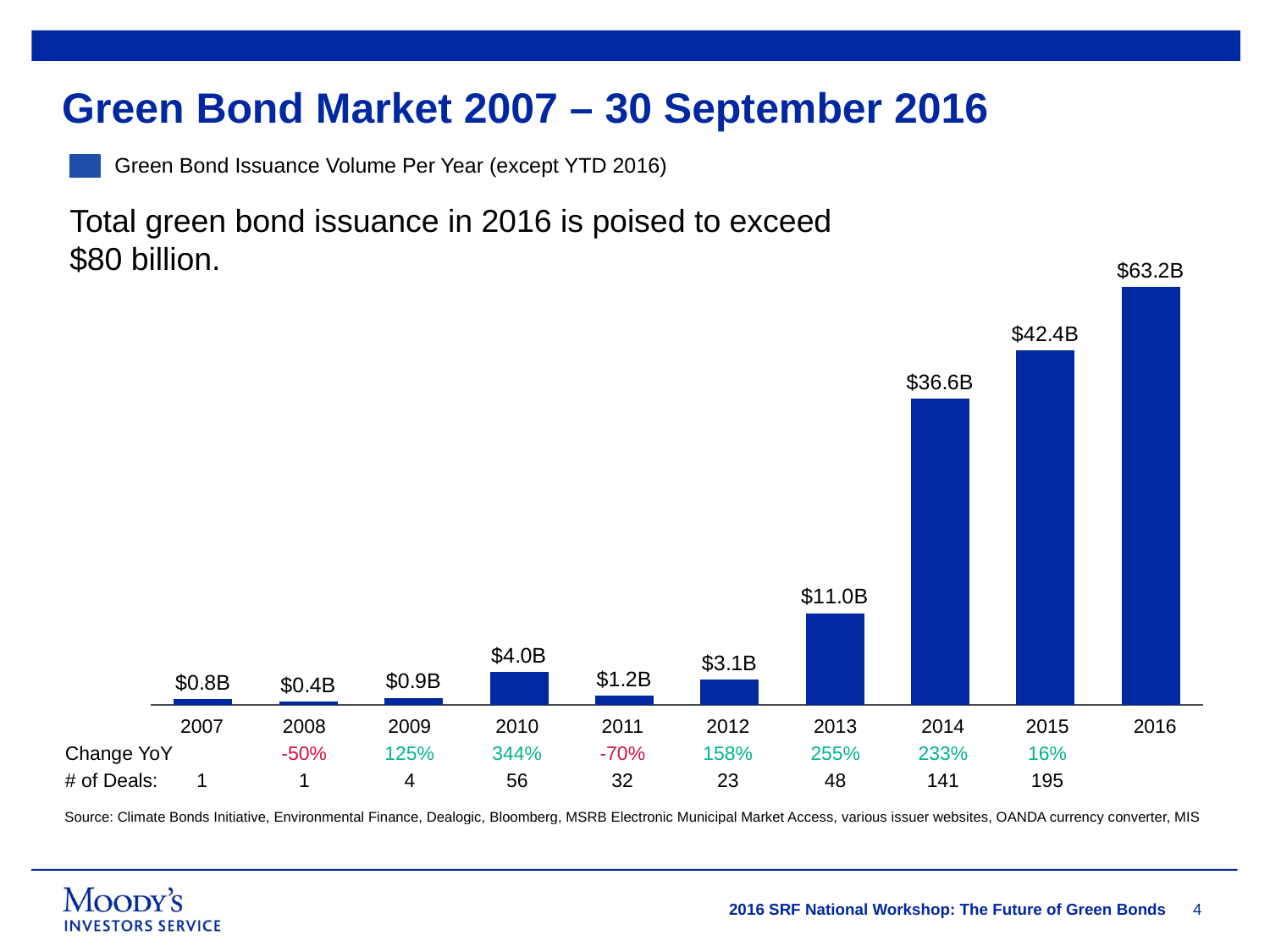
Which year has the lowest green bond issuance volume? 2008 Which year has the highest green bond issuance volume? 2016 Did green bond issuance volume rise or fall from 2013 to 2016? Rise How many deals were there in 2015? 195 Which year had a larger issuance volume, 2012 or 2011? 2012 What kind of chart is shown on the slide? Bar chart How many years are shown on the chart? 10 What was the green bond issuance volume in 2010? $4.0B What is the difference in issuance volume between 2016 and 2015? $20.8B What was the green bond issuance volume in 2014? $36.6B What was the year-over-year change in 2013? 255% What is the legend entry for the series shown in the chart? Green Bond Issuance Volume Per Year (except YTD 2016)